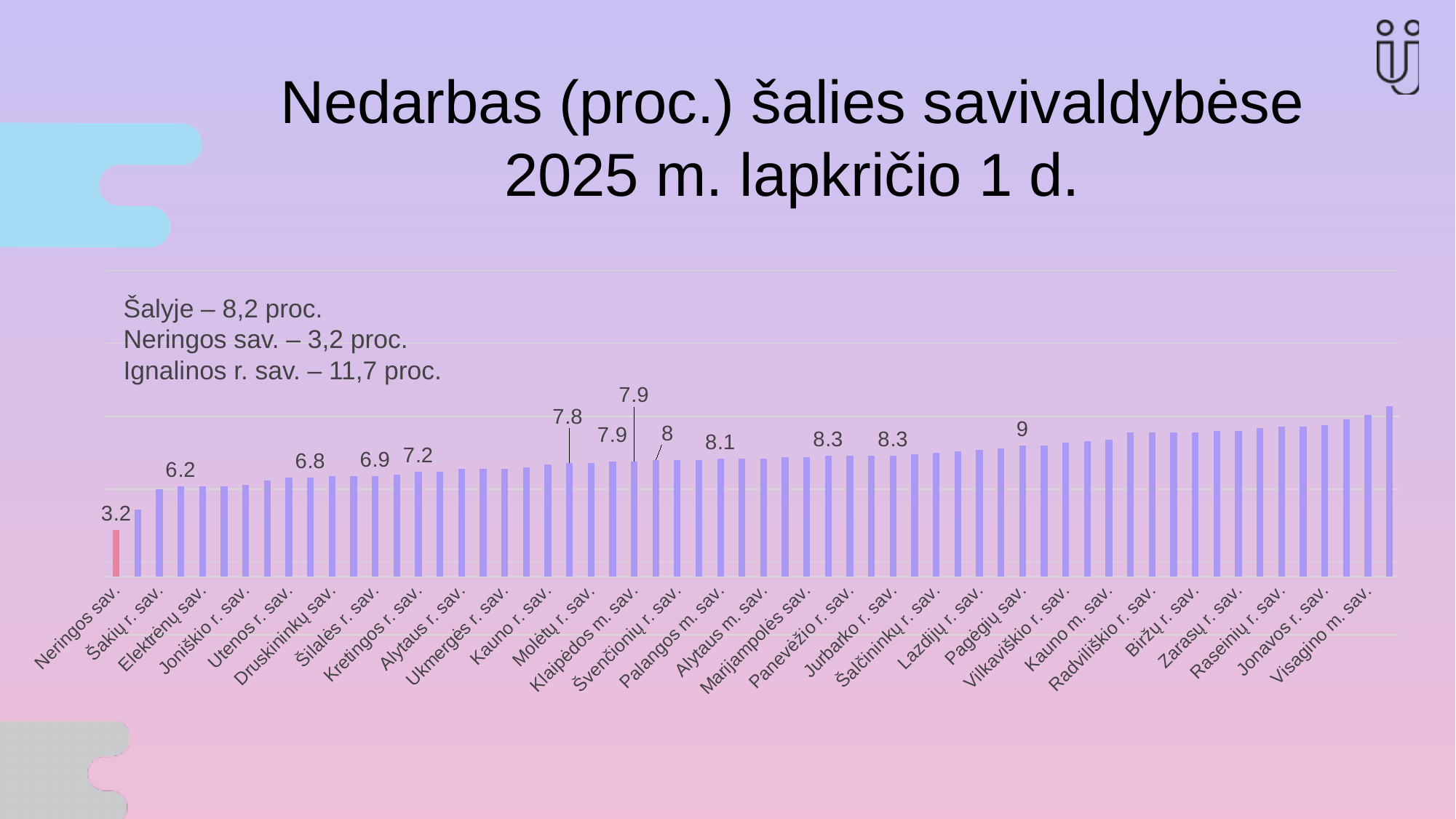
Which is larger, the value for Šakių r. sav. or the value for Jonavos r. sav.? Jonavos r. sav. Which bar in the chart is coloured differently (pink) from the others? Neringos sav. What is the data label shown for Šilalės r. sav.? 6.9 What is the unemployment value shown for Neringos sav.? 3.2 Do the bar values rise or fall from left to right along the x axis? rise Which labelled municipality has the highest bar in the chart? Visagino m. sav. Which is larger, the value for Visagino m. sav. or the value for Neringos sav.? Visagino m. sav. According to the text on the slide, what is the national (Šalyje) unemployment rate? 8,2 proc. What is the data label shown for Kretingos r. sav.? 7.2 Which municipality has the lowest bar in the chart? Neringos sav. What kind of chart is shown on the slide? bar chart What is the title of the chart slide? Nedarbas (proc.) šalies savivaldybėse 2025 m. lapkričio 1 d.